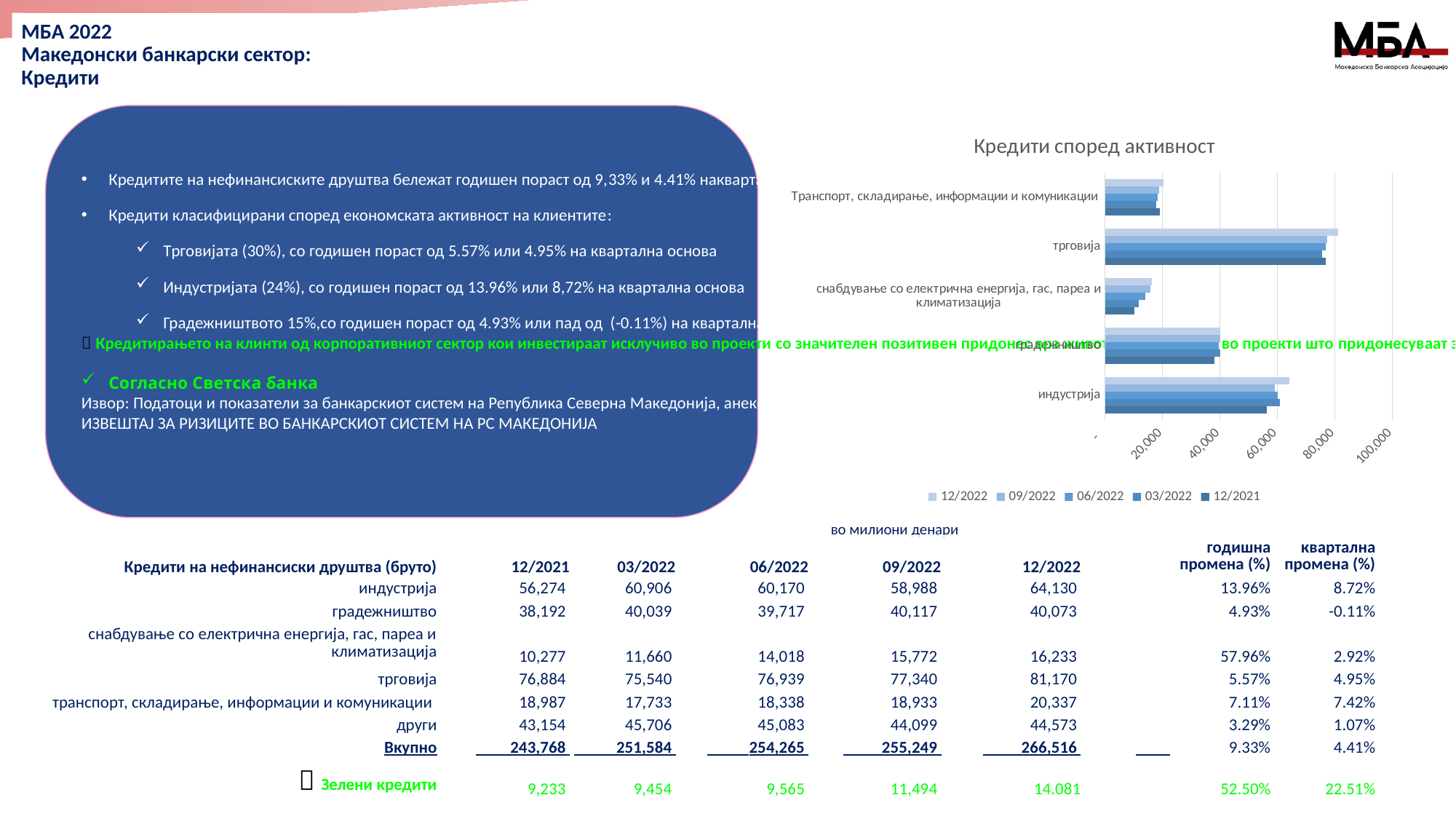
What type of chart is shown under the title "Кредити според активност"? bar chart In the "Кредити според активност" chart, is the 12/2022 value for трговија greater or less than 60,000? greater In the "Кредити според активност" chart, is the 12/2022 value for индустрија greater or less than 80,000? less In the "Кредити според активност" chart, which has the larger 12/2022 value: индустрија or трговија? трговија In the "Кредити според активност" chart, which has the larger 12/2022 value: Транспорт, складирање, информации и комуникации or снабдување со електрична енергија, гас, пареа и климатизација? Транспорт, складирање, информации и комуникации How many activity categories are plotted in the "Кредити според активност" chart? 5 What is the title of the chart on the right side of the slide? Кредити според активност In the "Кредити според активност" chart, which category has the shortest bar for 12/2022? снабдување со електрична енергија, гас, пареа и климатизација In the "Кредити според активност" chart, which category has the longest bars? трговија How many series does the legend of the "Кредити според активност" chart list? 5 Which series is listed first in the legend of the "Кредити според активност" chart? 12/2022 In the "Кредити според активност" chart, is the 12/2022 value for Транспорт, складирање, информации и комуникации greater or less than 40,000? less